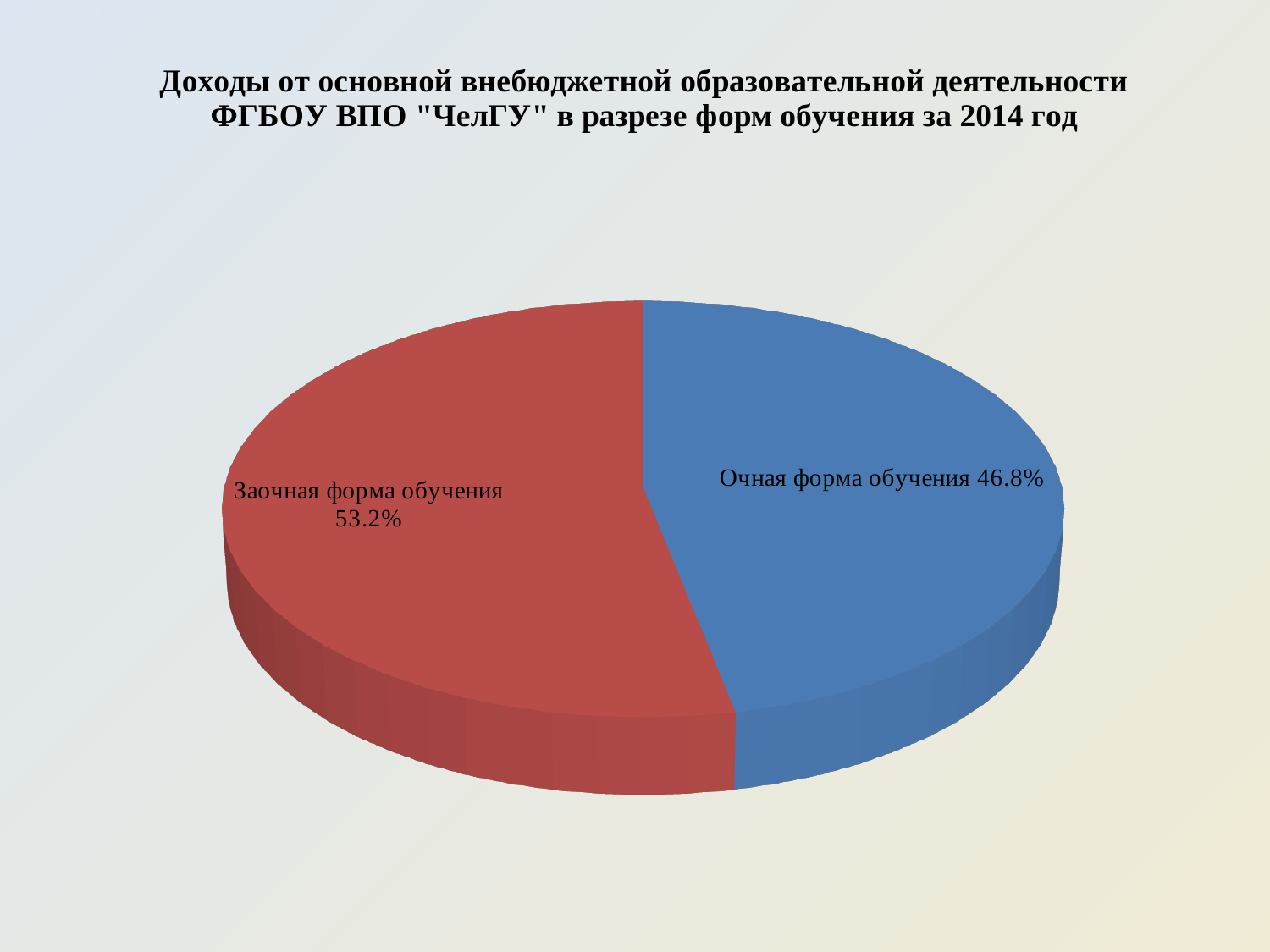
What share of the pie does "Заочная форма обучения" have? 53.2% What colour is the slice for "Очная форма обучения"? blue Which is larger: the share of "Очная форма обучения" or the share of "Заочная форма обучения"? Заочная форма обучения What kind of chart is shown on the slide? pie chart How many slices does the pie chart have? 2 Which year does the chart title say the data is for? 2014 What is the difference in percentage points between the shares of "Заочная форма обучения" and "Очная форма обучения"? 6.4 Which form of study has the smallest share of the pie? Очная форма обучения Which form of study has the largest share of the pie? Заочная форма обучения Is the share of "Очная форма обучения" greater or less than 50%? less What share of the pie does "Очная форма обучения" have? 46.8%